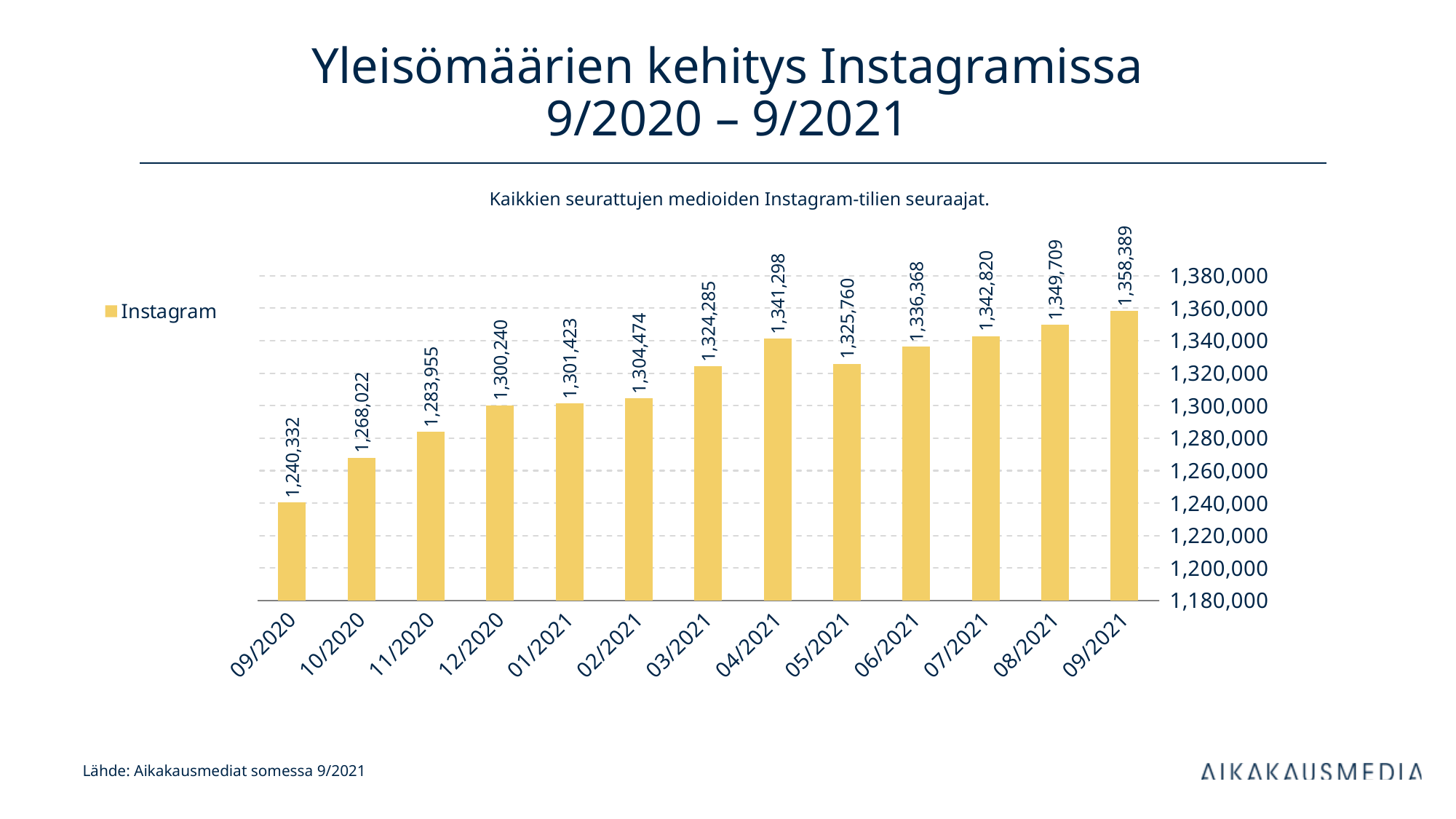
What is the Instagram follower count for 12/2020? 1,300,240 What kind of chart is shown on the slide? bar chart How many months are shown on the x axis of the chart? 13 What is the difference between the follower counts for 09/2021 and 09/2020? 118,057 What series name does the legend show? Instagram What is the Instagram follower count for 09/2020? 1,240,332 What is the difference between the follower counts for 04/2021 and 05/2021? 15,538 Which month has the lowest Instagram follower count? 09/2020 Which month has the highest Instagram follower count? 09/2021 Which is larger, the follower count for 04/2021 or for 05/2021? 04/2021 What is the Instagram follower count for 04/2021? 1,341,298 Is the follower count for 11/2020 greater or less than 1,300,000? less